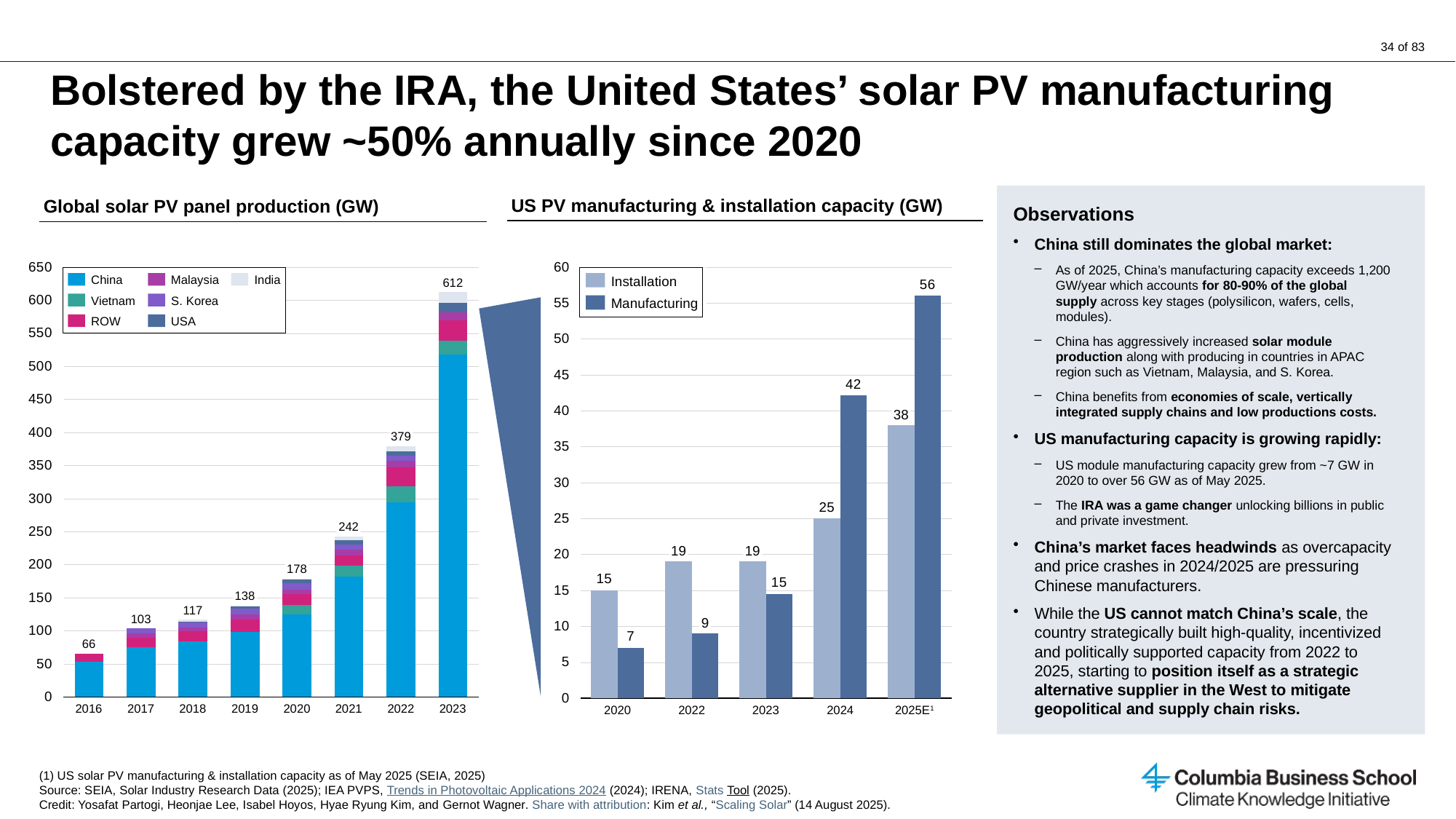
In the 'Global solar PV panel production (GW)' chart, what is the total production labeled for 2023? 612 In the 'Global solar PV panel production (GW)' chart, is the China segment for 2023 greater or less than 500? greater In the 'Global solar PV panel production (GW)' chart, how many series does the legend list? 7 In the 'Global solar PV panel production (GW)' chart, which year has the highest total production? 2023 What type of chart is the 'US PV manufacturing & installation capacity (GW)' chart? bar chart In the 'US PV manufacturing & installation capacity (GW)' chart, what is the difference between Manufacturing and Installation in 2024? 17 In the 'Global solar PV panel production (GW)' chart, what is the difference between the 2023 total and the 2022 total? 233 In the 'US PV manufacturing & installation capacity (GW)' chart, which is larger in 2020, Installation or Manufacturing? Installation In the 'US PV manufacturing & installation capacity (GW)' chart, what is the Installation value for 2024? 25 In the 'Global solar PV panel production (GW)' chart, do the total values rise or fall from 2016 to 2023? rise In the 'Global solar PV panel production (GW)' chart, what is the total production labeled for 2016? 66 In the 'US PV manufacturing & installation capacity (GW)' chart, what is the Manufacturing value for 2025E? 56